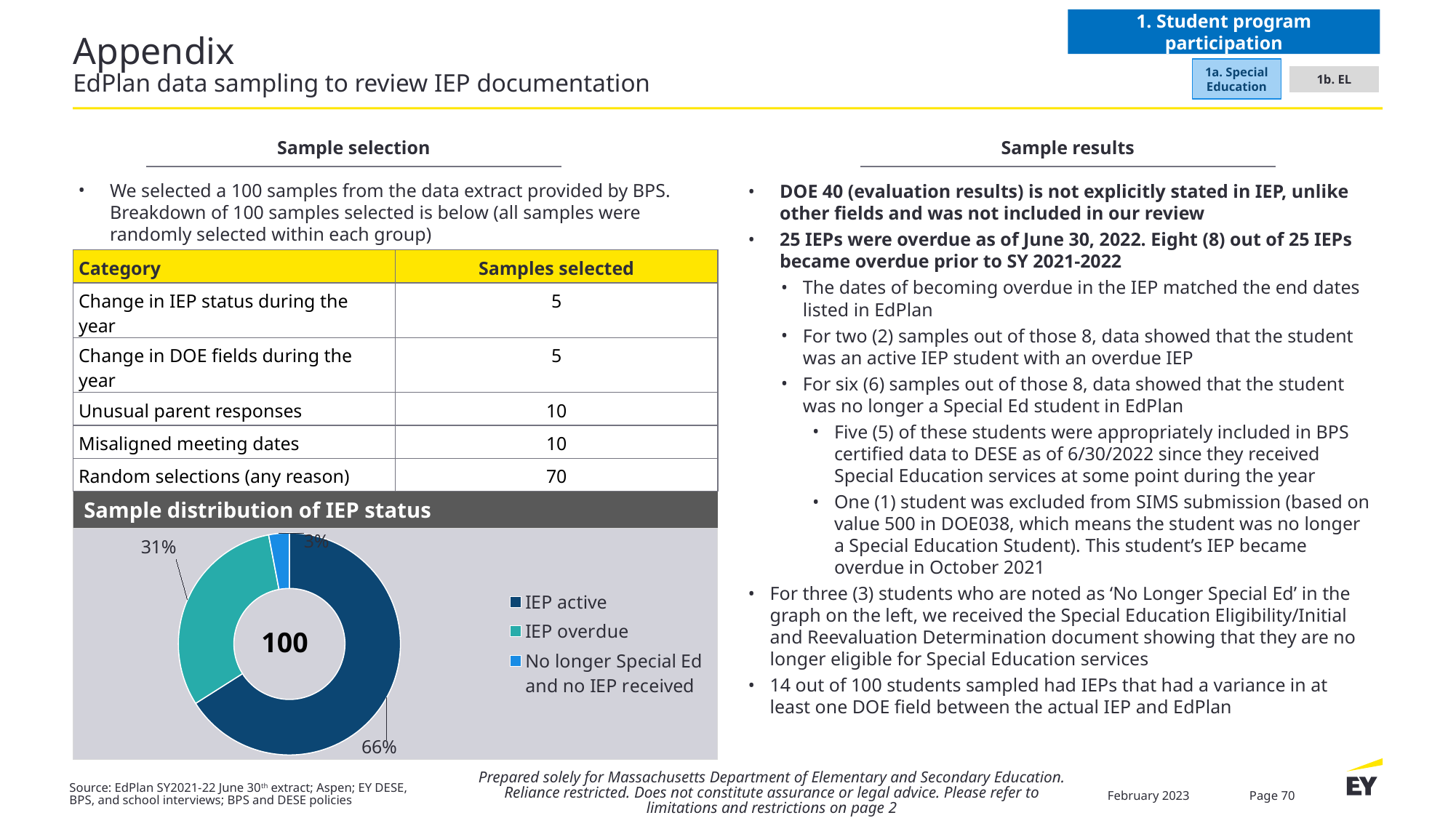
In the 'Sample distribution of IEP status' chart, what is the combined share of IEP overdue and 'No longer Special Ed and no IEP received'? 34% In the 'Sample distribution of IEP status' chart, what percentage is labelled for 'No longer Special Ed and no IEP received'? 3% In the 'Sample distribution of IEP status' chart, which is larger: IEP overdue or 'No longer Special Ed and no IEP received'? IEP overdue How many categories does the legend of the 'Sample distribution of IEP status' chart list? 3 Which category has the smallest share in the 'Sample distribution of IEP status' chart? No longer Special Ed and no IEP received What number is shown in the centre of the 'Sample distribution of IEP status' donut chart? 100 In the 'Sample distribution of IEP status' chart, what percentage is labelled for IEP active? 66% In the 'Sample distribution of IEP status' chart, what is the difference in percentage points between IEP active and IEP overdue? 35 What is the title of the chart on the slide? Sample distribution of IEP status What kind of chart is shown under 'Sample distribution of IEP status'? Donut (pie) chart Which category has the largest share in the 'Sample distribution of IEP status' chart? IEP active In the 'Sample distribution of IEP status' chart, what percentage is labelled for IEP overdue? 31%